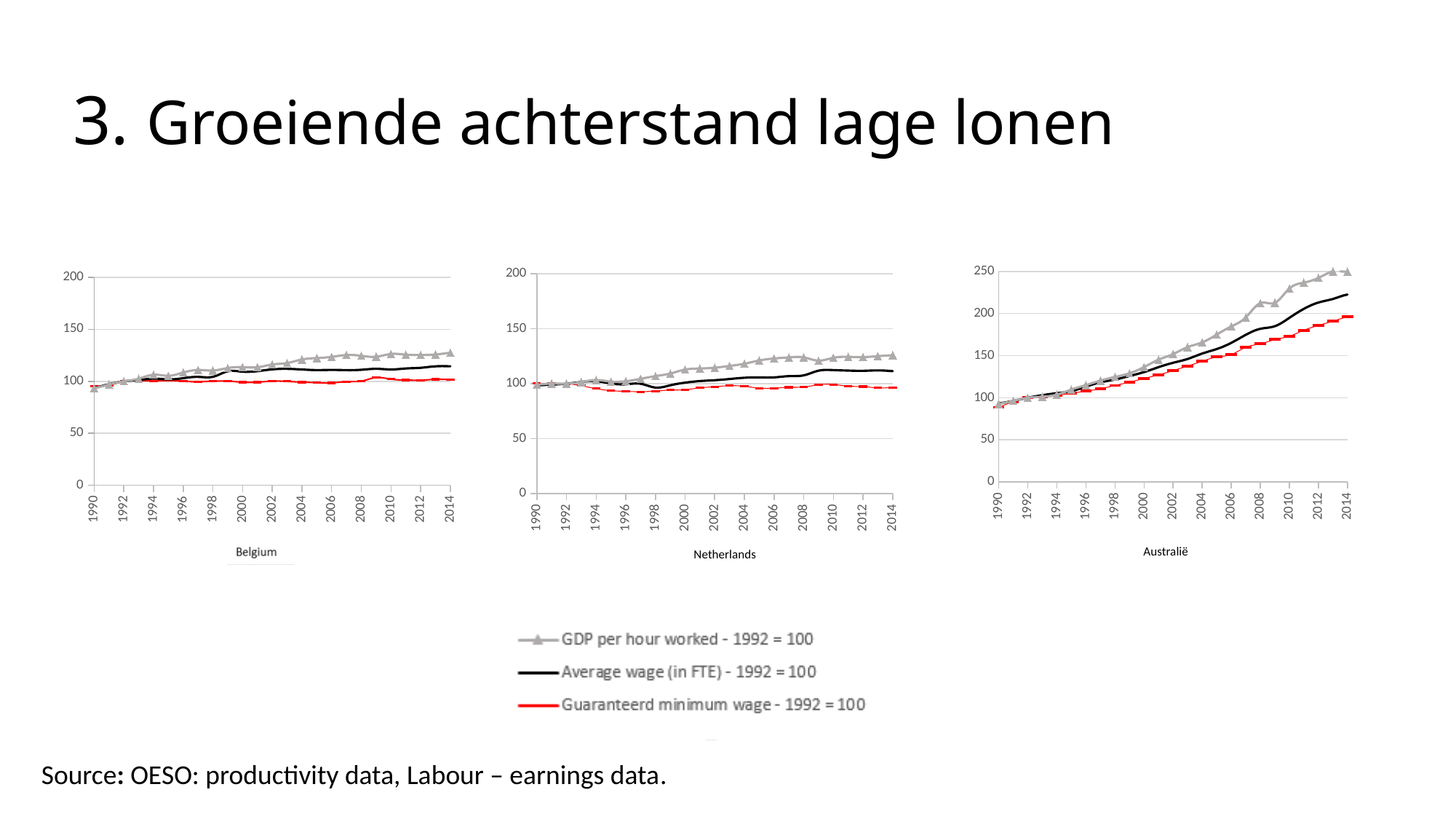
What kind of chart is the Belgium chart? line chart In the Australië chart, is the value for Guaranteerd minimum wage in 2014 greater or less than 150? greater In the Australië chart, is the value for GDP per hour worked in 2014 greater or less than 200? greater Which of the three charts has a y-axis that goes up to 250? Australië In the Netherlands chart, which series has the lowest value in 2014? Guaranteerd minimum wage - 1992 = 100 In the Belgium chart, which series has the highest value in 2014? GDP per hour worked - 1992 = 100 Which is larger in 2014: GDP per hour worked in the Australië chart or GDP per hour worked in the Belgium chart? Australië How many series does the shared legend list? 3 How many charts are shown on the slide? 3 In the Netherlands chart, is the value for Guaranteerd minimum wage in 2014 greater or less than 100? less In the Australië chart, does the Average wage (in FTE) series rise or fall from 1990 to 2014? rise